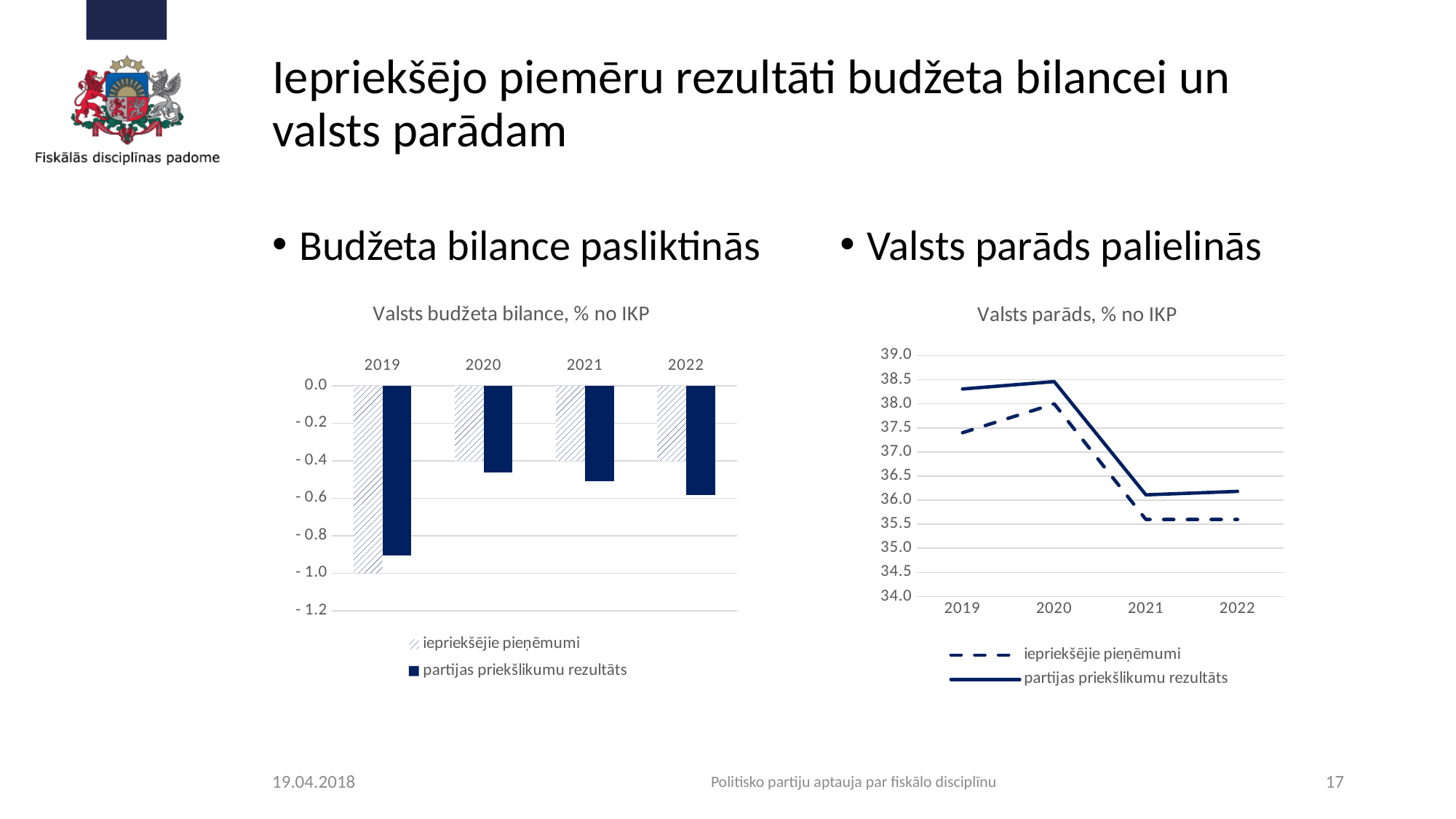
In the right chart 'Valsts parāds, % no IKP', which year has the highest value for 'partijas priekšlikumu rezultāts'? 2020 How many series does the legend of the left chart 'Valsts budžeta bilance, % no IKP' list? 2 In the right chart 'Valsts parāds, % no IKP', which series is higher in 2021: 'iepriekšējie pieņēmumi' or 'partijas priekšlikumu rezultāts'? partijas priekšlikumu rezultāts What type of chart is the left chart titled 'Valsts budžeta bilance, % no IKP'? bar chart What type of chart is the right chart titled 'Valsts parāds, % no IKP'? line chart In the left chart 'Valsts budžeta bilance, % no IKP', what is the value of 'iepriekšējie pieņēmumi' for 2021? -0.4 How many years are shown on the x axis of the right chart 'Valsts parāds, % no IKP'? 4 In the left chart 'Valsts budžeta bilance, % no IKP', what is the value of 'iepriekšējie pieņēmumi' for 2019? -1.0 In the right chart 'Valsts parāds, % no IKP', does the 'partijas priekšlikumu rezultāts' line rise or fall from 2020 to 2021? fall In the right chart 'Valsts parāds, % no IKP', is the 'iepriekšējie pieņēmumi' value for 2019 greater or less than 37.0? greater In the left chart 'Valsts budžeta bilance, % no IKP', is the 'partijas priekšlikumu rezultāts' value for 2022 greater or less than -0.4? less In the left chart 'Valsts budžeta bilance, % no IKP', which year has the lowest (most negative) value for 'partijas priekšlikumu rezultāts'? 2019